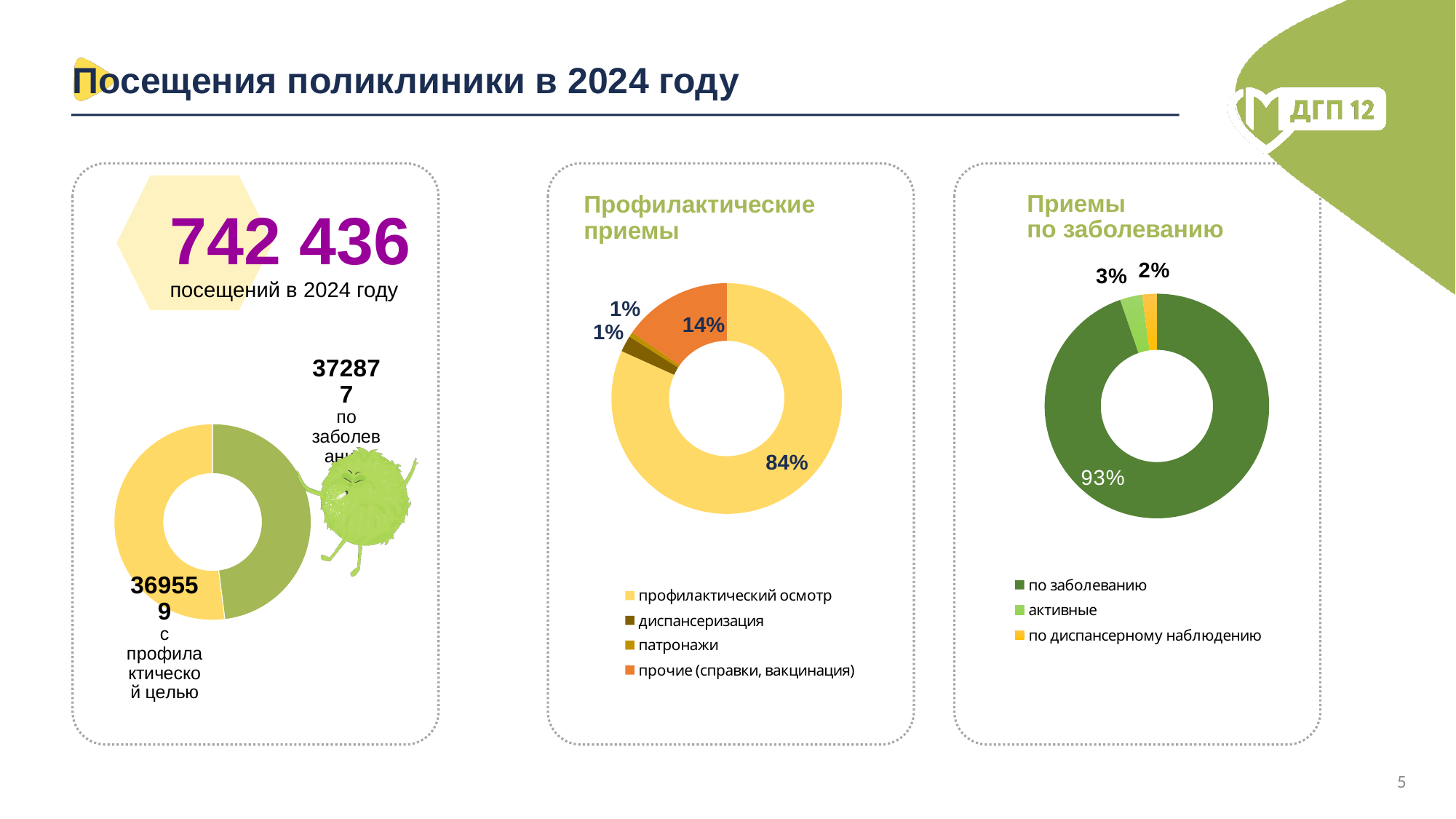
In the 'Приемы по заболеванию' chart, which category has the smallest share? по диспансерному наблюдению In the 'Приемы по заболеванию' chart, what share is 'активные'? 3% In the 'Профилактические приемы' chart, what share is 'прочие (справки, вакцинация)'? 14% In the left donut chart, what is the value for 'по заболеванию'? 372877 How many categories does the legend of the 'Профилактические приемы' chart list? 4 In the 'Приемы по заболеванию' chart, what is the difference between the shares of 'активные' and 'по диспансерному наблюдению'? 1% In the 'Профилактические приемы' chart, which category has the largest share? профилактический осмотр In the 'Профилактические приемы' chart, what share is 'профилактический осмотр'? 84% In the 'Приемы по заболеванию' chart, what share is 'по заболеванию'? 93% What kind of chart is used in the 'Профилактические приемы' panel? Pie (donut) chart